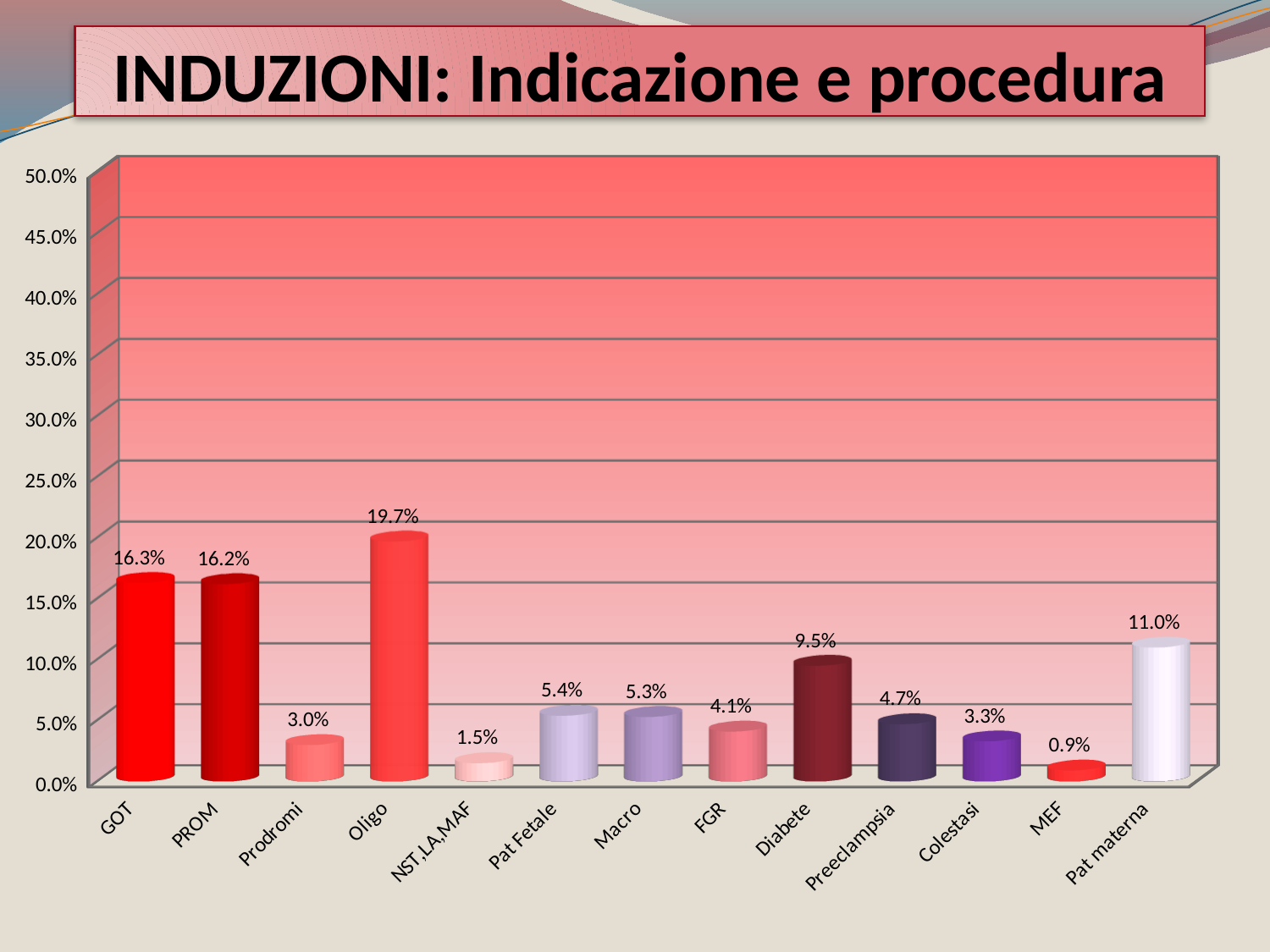
Which category has the highest value? Oligo What is the value for Diabete? 9.5% Which category has the lowest value? MEF What kind of chart is shown on the slide? bar chart What is the difference between the values for Oligo and GOT? 3.4% What is the value for Oligo? 19.7% What is the difference between the values for Diabete and Preeclampsia? 4.8% What is the value for NST,LA,MAF? 1.5% How many categories are shown on the x axis? 13 Which is larger, the value for Pat materna or the value for Diabete? Pat materna What is the value for Pat materna? 11.0% Is the value for Pat materna greater or less than 10.0%? greater